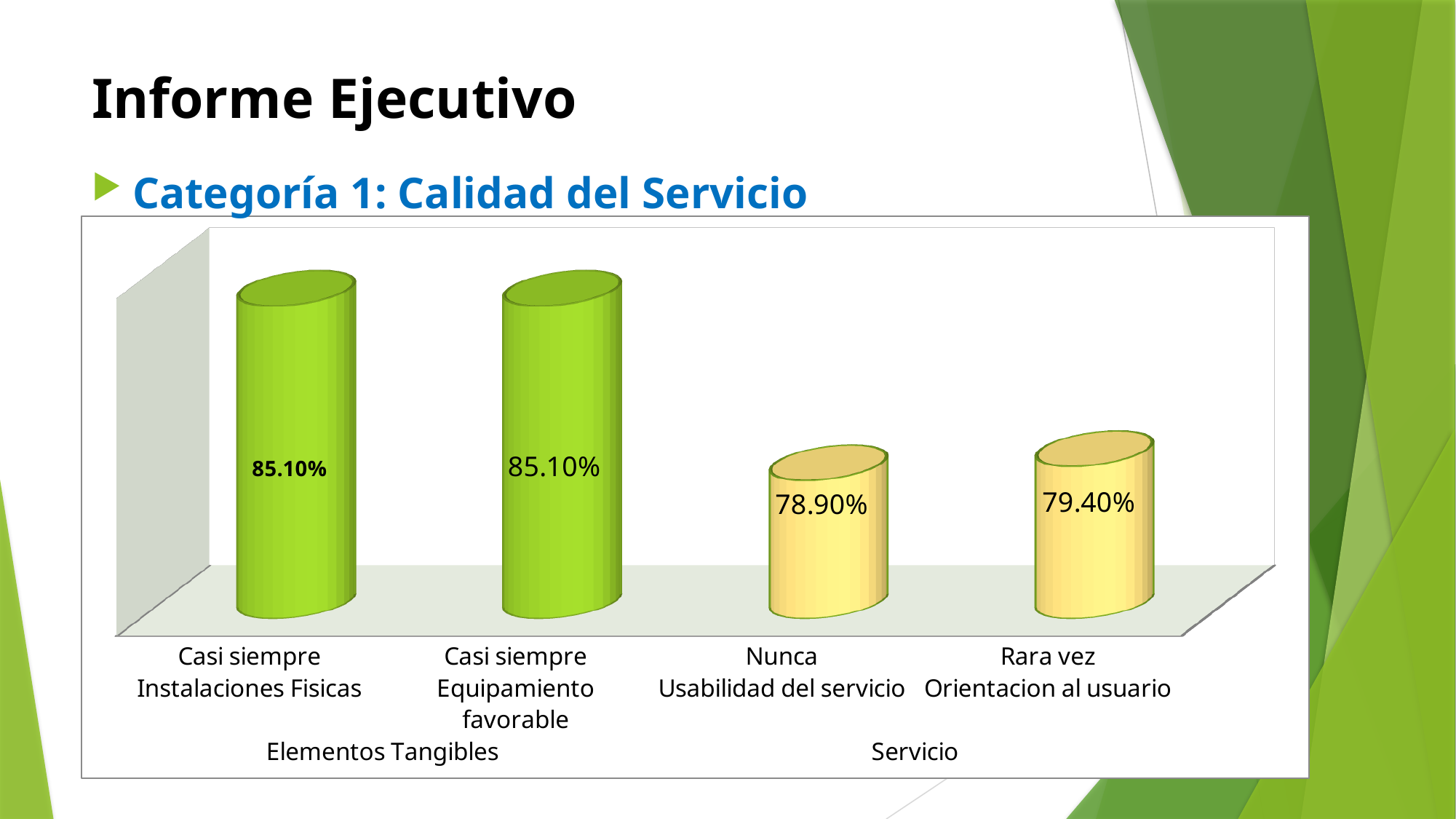
What is the difference between the values for Instalaciones Fisicas and Usabilidad del servicio? 6.20% What kind of chart is shown on the slide? Bar chart How many bars are plotted in the chart? 4 Which category has the lowest value? Usabilidad del servicio Which is larger, the value for Equipamiento favorable or the value for Orientacion al usuario? Equipamiento favorable Which is larger, the value for Orientacion al usuario or the value for Usabilidad del servicio? Orientacion al usuario What is the value shown for Instalaciones Fisicas? 85.10% What is the value shown for Usabilidad del servicio? 78.90% Which response label is shown above Usabilidad del servicio? Nunca What is the difference between the values for Orientacion al usuario and Usabilidad del servicio? 0.50% What is the value shown for Orientacion al usuario? 79.40% What is the value shown for Equipamiento favorable? 85.10%